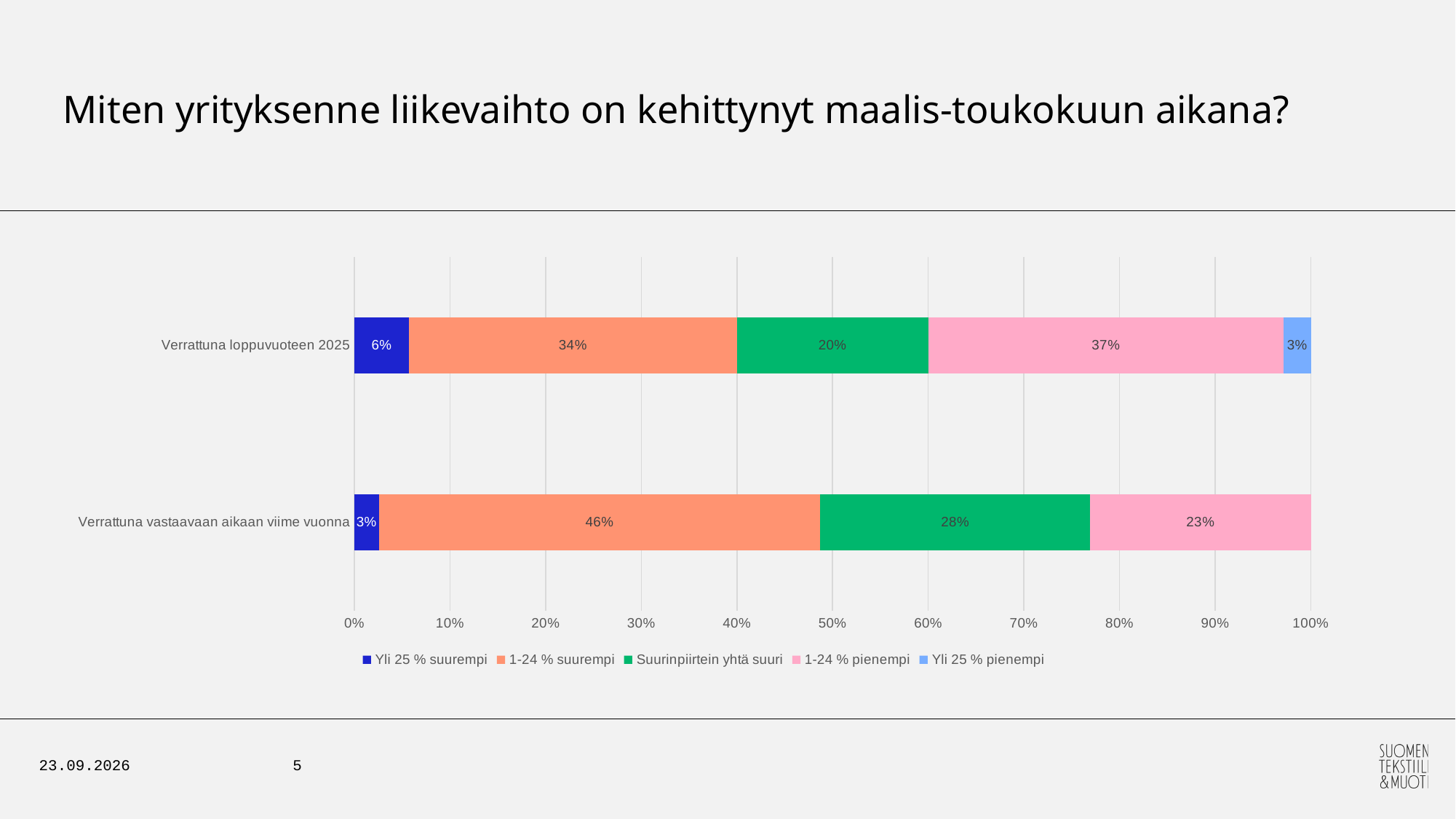
Which series has the largest share in the "Verrattuna vastaavaan aikaan viime vuonna" bar? 1-24 % suurempi What is the value of "Suurinpiirtein yhtä suuri" for "Verrattuna vastaavaan aikaan viime vuonna"? 28% What is the difference between the "1-24 % suurempi" values for "Verrattuna vastaavaan aikaan viime vuonna" and "Verrattuna loppuvuoteen 2025"? 12% Which series has the largest share in the "Verrattuna loppuvuoteen 2025" bar? 1-24 % pienempi What is the title of the slide? Miten yrityksenne liikevaihto on kehittynyt maalis-toukokuun aikana? How many categories are plotted on the chart? 2 What is the value of "1-24 % suurempi" for "Verrattuna loppuvuoteen 2025"? 34% What is the value of "1-24 % pienempi" for "Verrattuna vastaavaan aikaan viime vuonna"? 23% Which category has the larger "Yli 25 % suurempi" value? Verrattuna loppuvuoteen 2025 What is the value of "Yli 25 % pienempi" for "Verrattuna loppuvuoteen 2025"? 3% How many series does the legend list? 5 What kind of chart is shown on the slide? Stacked bar chart